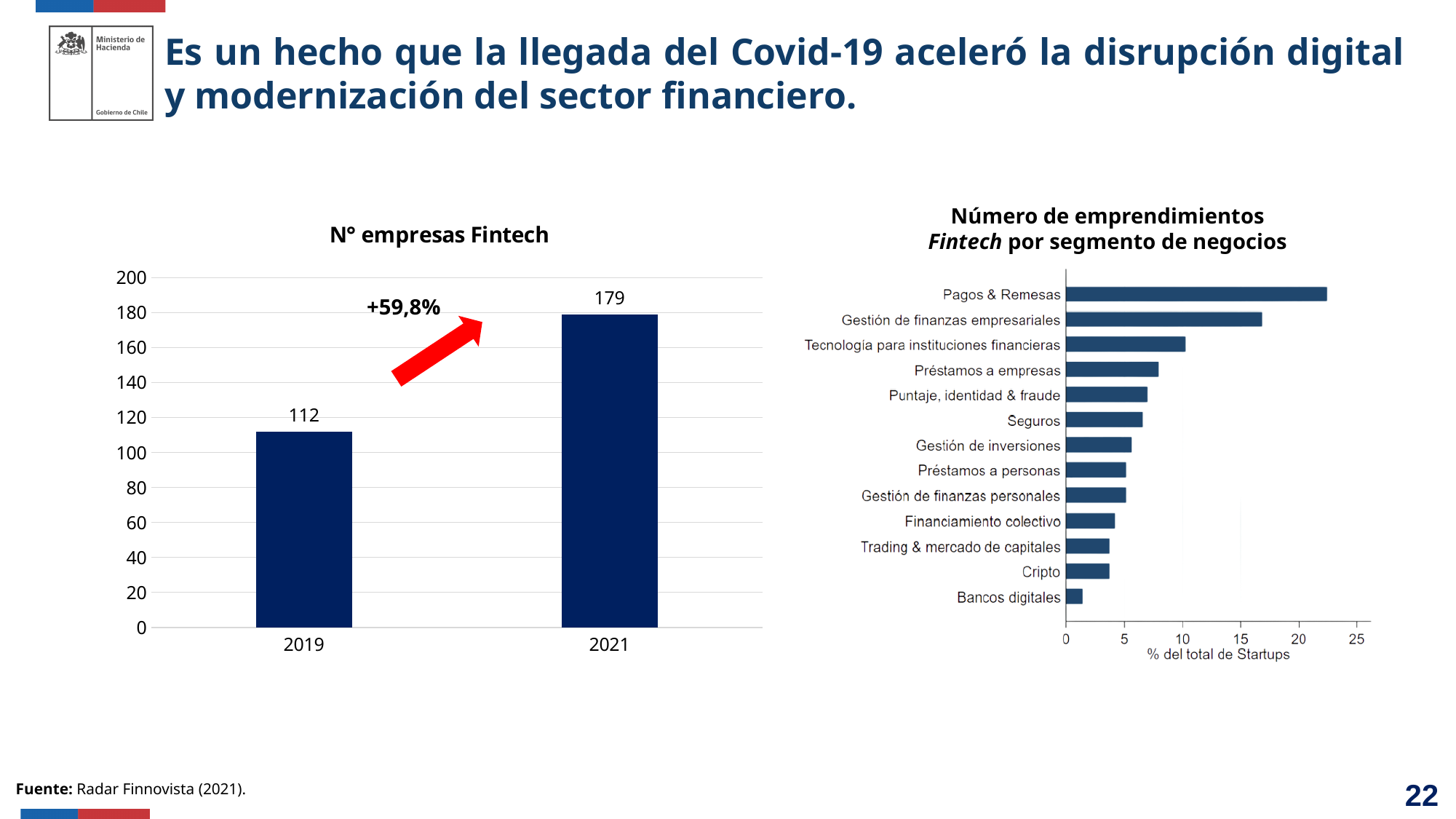
In the 'Número de emprendimientos Fintech por segmento de negocios' chart, is the value for Pagos & Remesas greater or less than 20? greater In the 'N° empresas Fintech' chart, which year has the higher value, 2019 or 2021? 2021 In the 'N° empresas Fintech' chart, what is the value for 2021? 179 In the 'Número de emprendimientos Fintech por segmento de negocios' chart, how many business segments are listed? 13 In the 'N° empresas Fintech' chart, what is the difference between the 2021 and 2019 values? 67 In the 'N° empresas Fintech' chart, what is the value for 2019? 112 In the 'Número de emprendimientos Fintech por segmento de negocios' chart, which segment has the lowest share? Bancos digitales In the 'N° empresas Fintech' chart, how many years are plotted? 2 In the 'Número de emprendimientos Fintech por segmento de negocios' chart, is the value for Seguros greater or less than 10? less In the 'Número de emprendimientos Fintech por segmento de negocios' chart, which segment has the highest share? Pagos & Remesas In the 'N° empresas Fintech' chart, what percentage change is annotated between 2019 and 2021? +59,8% What kind of chart is the 'N° empresas Fintech' chart? Bar chart